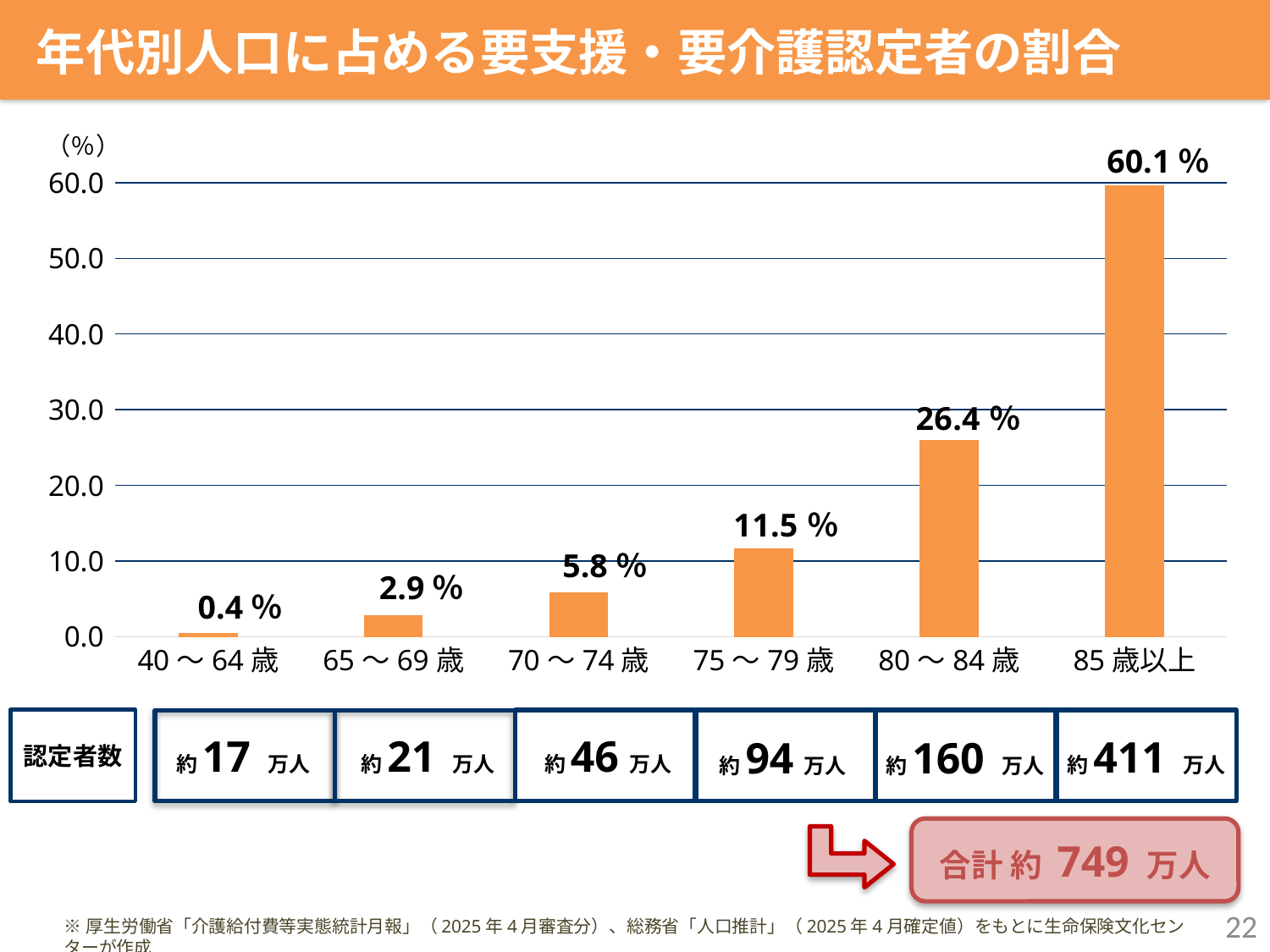
What is the value for 85歳以上? 60.1 % What kind of chart is shown on the slide? bar chart Which age group has the lowest value? 40～64歳 What is the value for 40～64歳? 0.4 % Which is larger, the value for 80～84歳 or the value for 75～79歳? 80～84歳 Do the values rise or fall as the age groups move from left to right? rise How many age groups are shown in the chart? 6 What is the value for 75～79歳? 11.5 % What is the value for 65～69歳? 2.9 % What is the difference between the values for 75～79歳 and 70～74歳? 5.7 % Which age group has the highest value? 85歳以上 What is the difference between the values for 85歳以上 and 80～84歳? 33.7 %